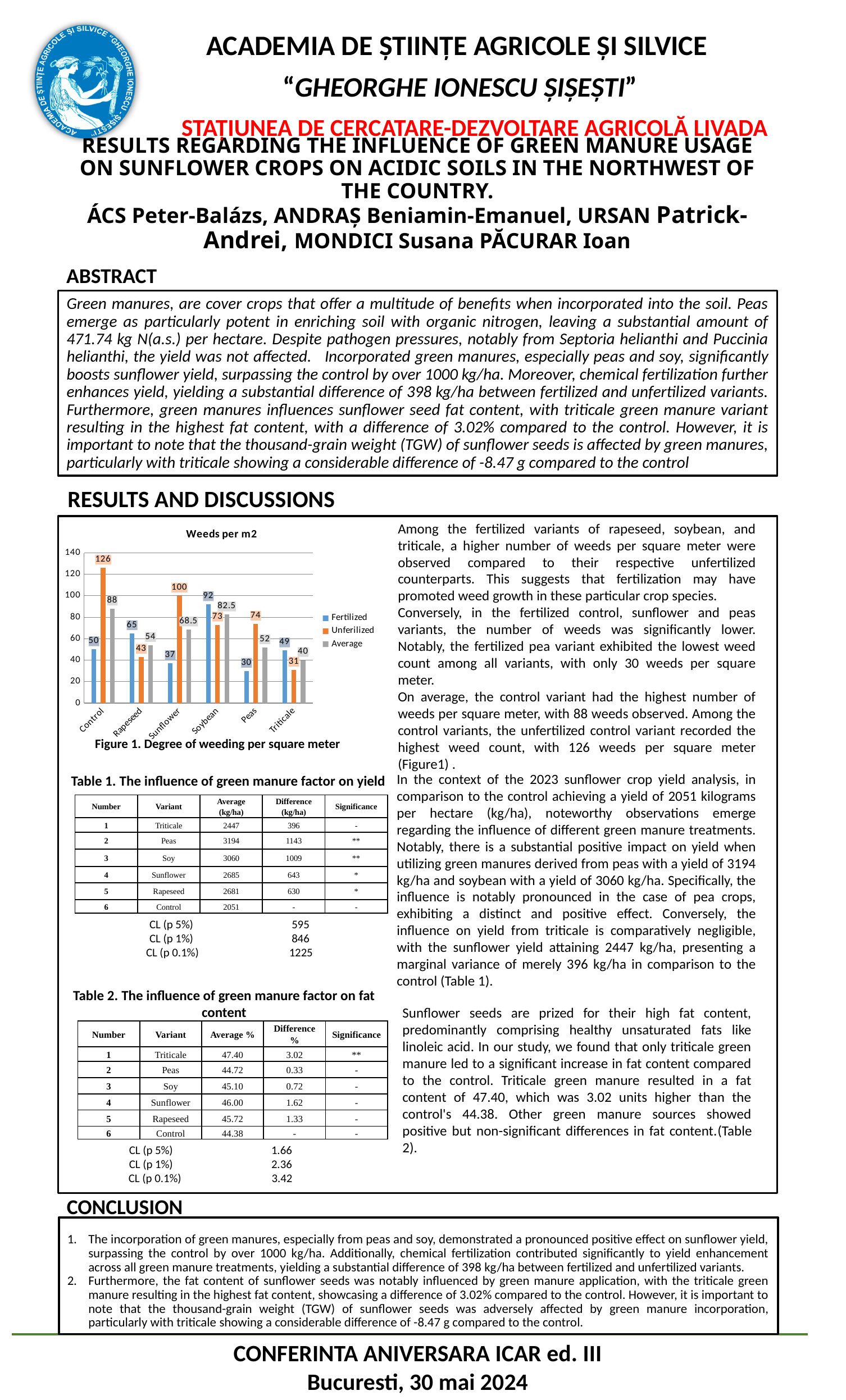
How many categories are shown on the x axis of the Weeds per m2 chart? 6 What is the Average value for Triticale in the Weeds per m2 chart? 40 What is the Average value for Sunflower in the Weeds per m2 chart? 68.5 What is the title of the chart? Weeds per m2 What kind of chart is shown in Figure 1? bar chart What is the Fertilized value for Peas in the Weeds per m2 chart? 30 Which is larger for Soybean in the Weeds per m2 chart, the Fertilized or the Unfertilized value? Fertilized Which category has the lowest Fertilized value in the Weeds per m2 chart? Peas What is the difference between the Unfertilized and Fertilized values for Sunflower in the Weeds per m2 chart? 63 Which category has the highest Average value in the Weeds per m2 chart? Control How many series does the legend of the Weeds per m2 chart list? 3 What is the Unfertilized value for Control in the Weeds per m2 chart? 126